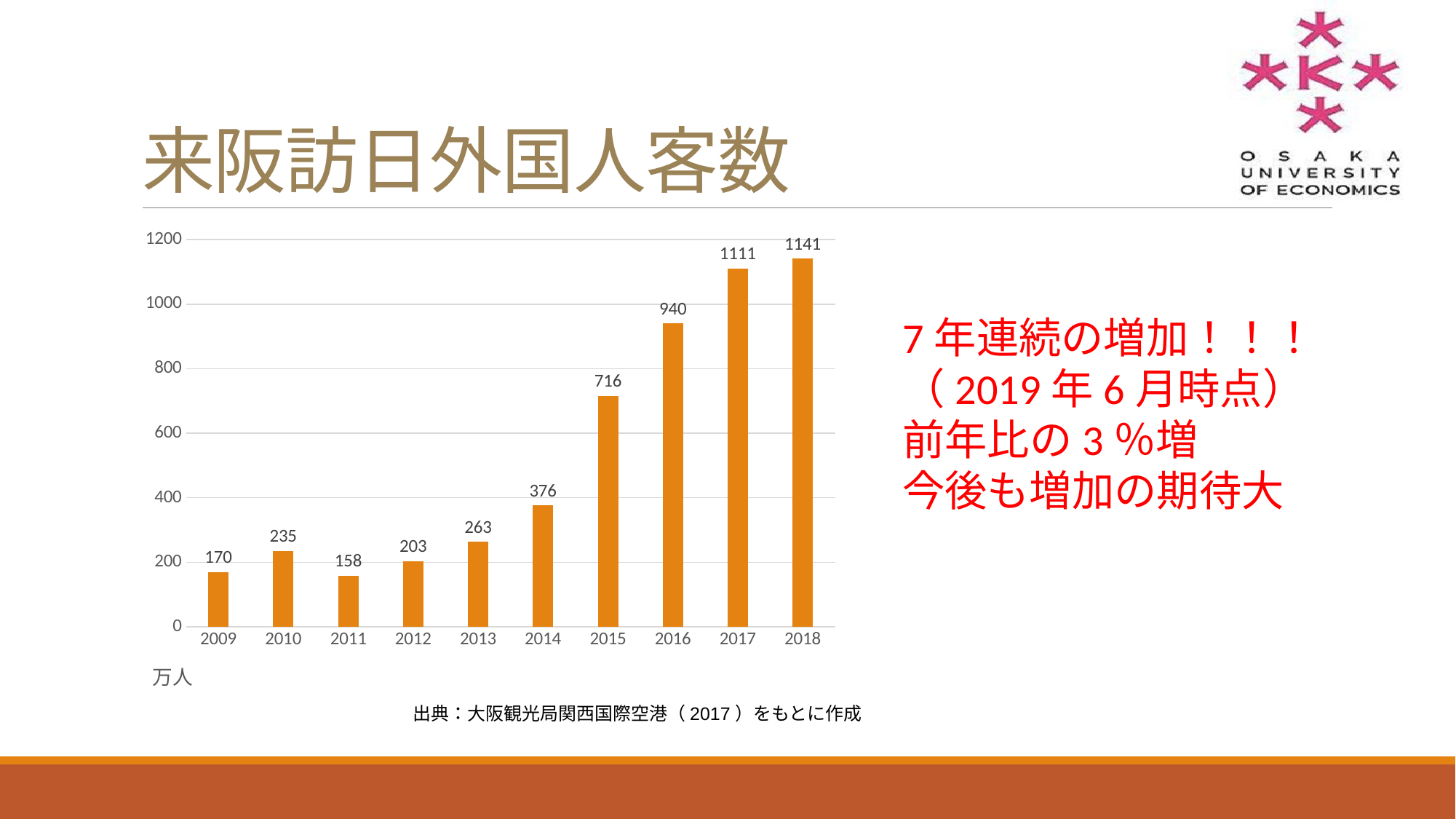
What is the difference between the values for 2017 and 2016? 171 Which is larger, the value for 2010 or the value for 2012? 2010 How many years are shown on the x axis? 10 What is the value for 2015? 716 What kind of chart is shown on the slide? bar chart What is the difference between the values for 2014 and 2013? 113 Which year has the lowest value? 2011 Which year has the highest value? 2018 Do the values generally rise or fall from 2011 to 2018? rise What is the value for 2011? 158 Is the value for 2016 greater or less than 800? greater What is the value for 2018? 1141